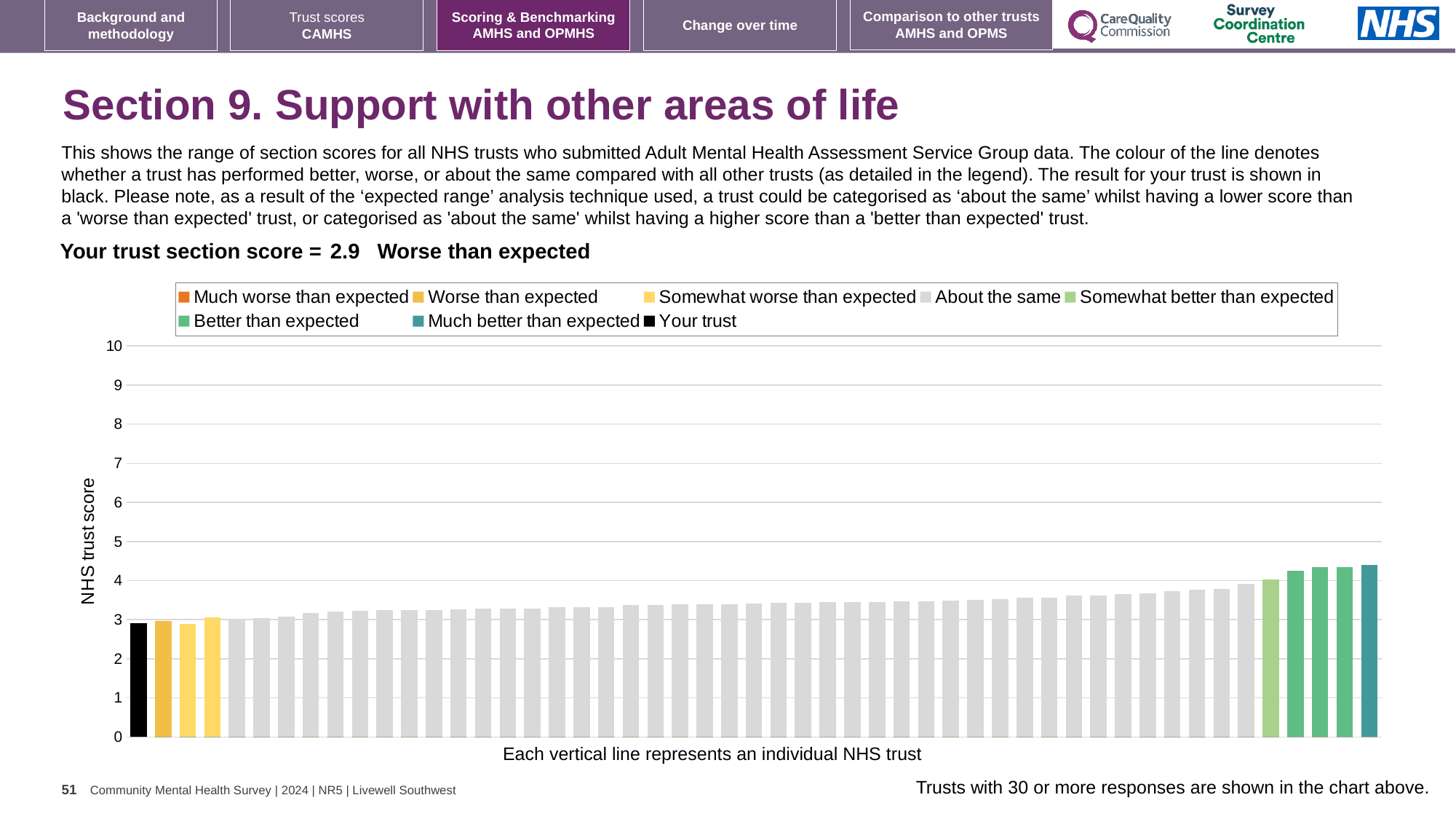
How many entries does the chart legend list? 8 What is the label on the vertical axis of the chart? NHS trust score Is the value of the tallest bar (the 'Much better than expected' trust) greater or less than 4? greater What colour is the bar representing your trust? black What is your trust's section score for Section 9, Support with other areas of life? 2.9 Which legend category does the tallest bar on the right of the chart belong to? Much better than expected What is the highest value shown on the vertical axis? 10 What kind of chart is shown on the slide? bar chart Do the bar values rise or fall from left to right along the x axis? rise Is the value for your trust greater or less than 5? less Which performance category is your trust placed in for this section? Worse than expected How many bars are coloured as 'Much better than expected'? 1